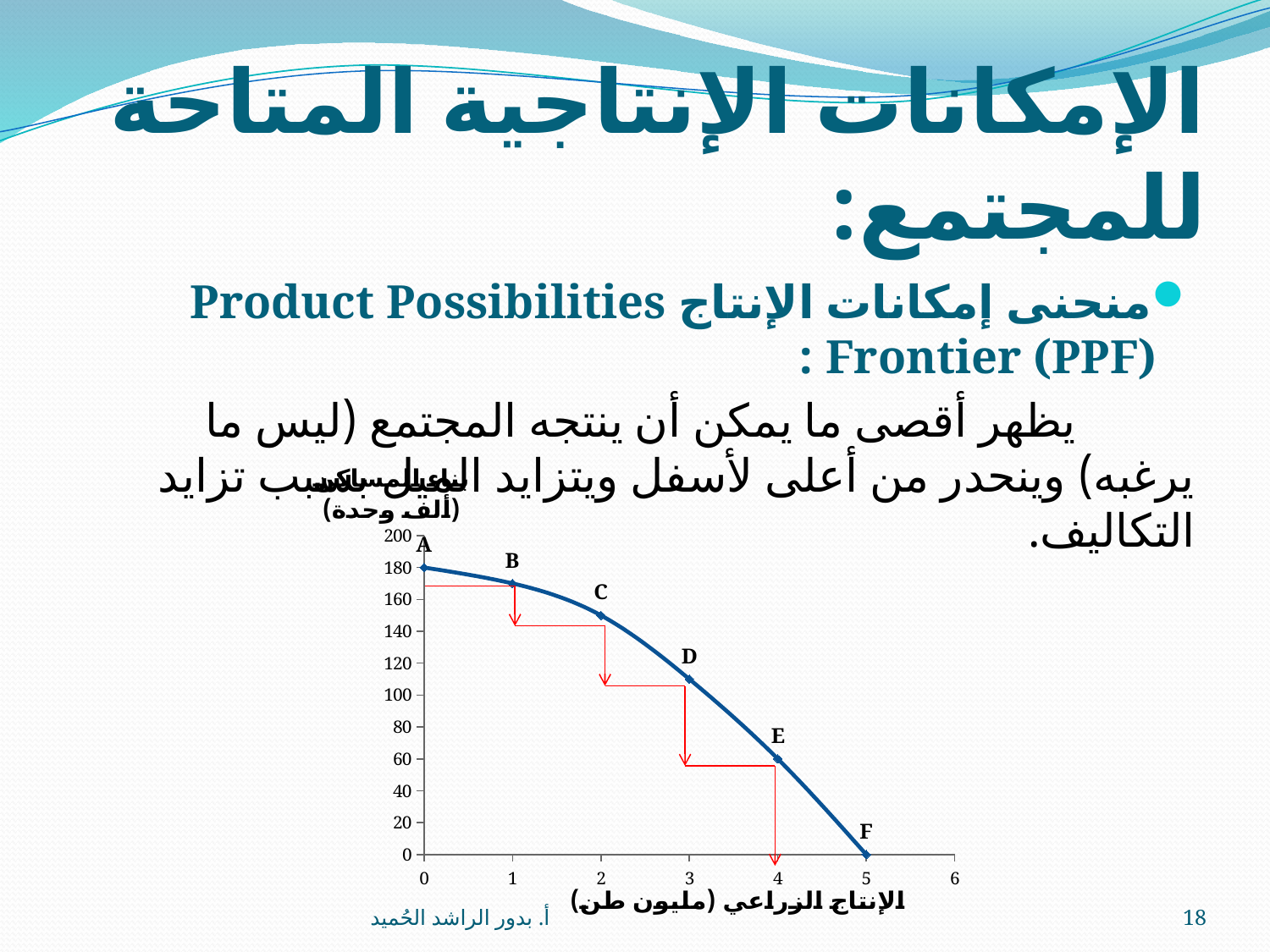
Which labelled point has the lowest value on the vertical axis? F How many labelled points (A to F) are plotted on the curve? 6 What is the horizontal-axis value at point F? 5 Do the values on the curve rise or fall as the x-axis value increases? fall What kind of chart is shown on the slide? line chart What is the vertical-axis value at point A? 180 Is the vertical-axis value at point D greater or less than 100? greater Is the vertical-axis value at point C greater or less than 160? less Which labelled point has the highest value on the vertical axis? A What is the vertical-axis value at point E? 60 Which point has a larger vertical-axis value, C or D? C What is the horizontal-axis value at point C? 2